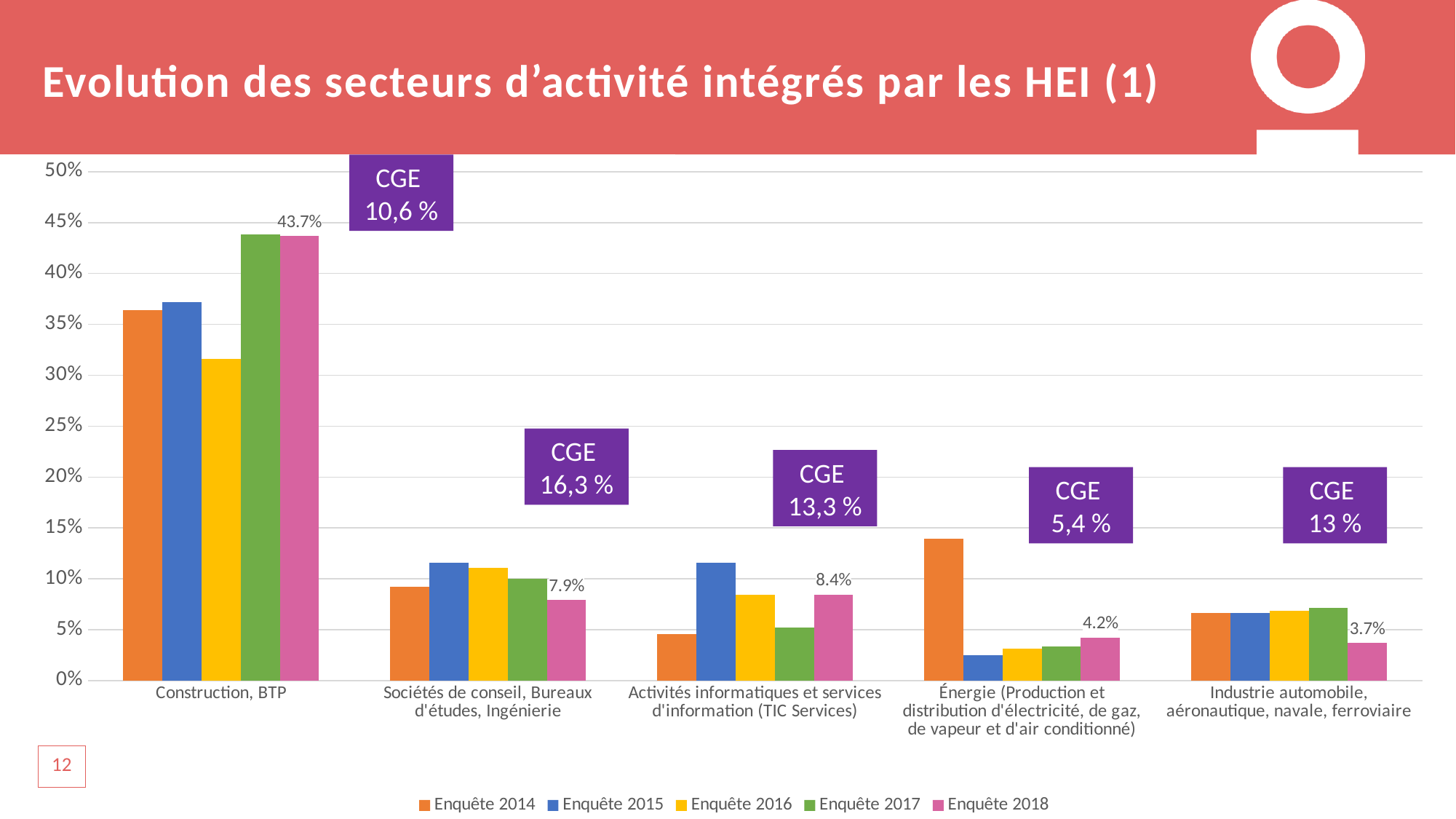
Is the Enquête 2016 value for Construction, BTP greater or less than 35%? less Is the Enquête 2014 value for Énergie (Production et distribution d'électricité, de gaz, de vapeur et d'air conditionné) greater or less than 10%? greater Which sector has the lowest Enquête 2018 value? Industrie automobile, aéronautique, navale, ferroviaire What is the Enquête 2018 value for Industrie automobile, aéronautique, navale, ferroviaire? 3.7% What kind of chart is shown on the slide? Bar chart Which has the larger Enquête 2018 value: Activités informatiques et services d'information (TIC Services) or Sociétés de conseil, Bureaux d'études, Ingénierie? Activités informatiques et services d'information (TIC Services) Which sector has the highest Enquête 2018 value? Construction, BTP What is the difference between the Enquête 2018 values for Construction, BTP and Sociétés de conseil, Bureaux d'études, Ingénierie? 35.8 percentage points How many series does the legend list? 5 What is the Enquête 2018 value for Construction, BTP? 43.7% How many sectors are shown on the x axis? 5 What is the Enquête 2018 value for Énergie (Production et distribution d'électricité, de gaz, de vapeur et d'air conditionné)? 4.2%